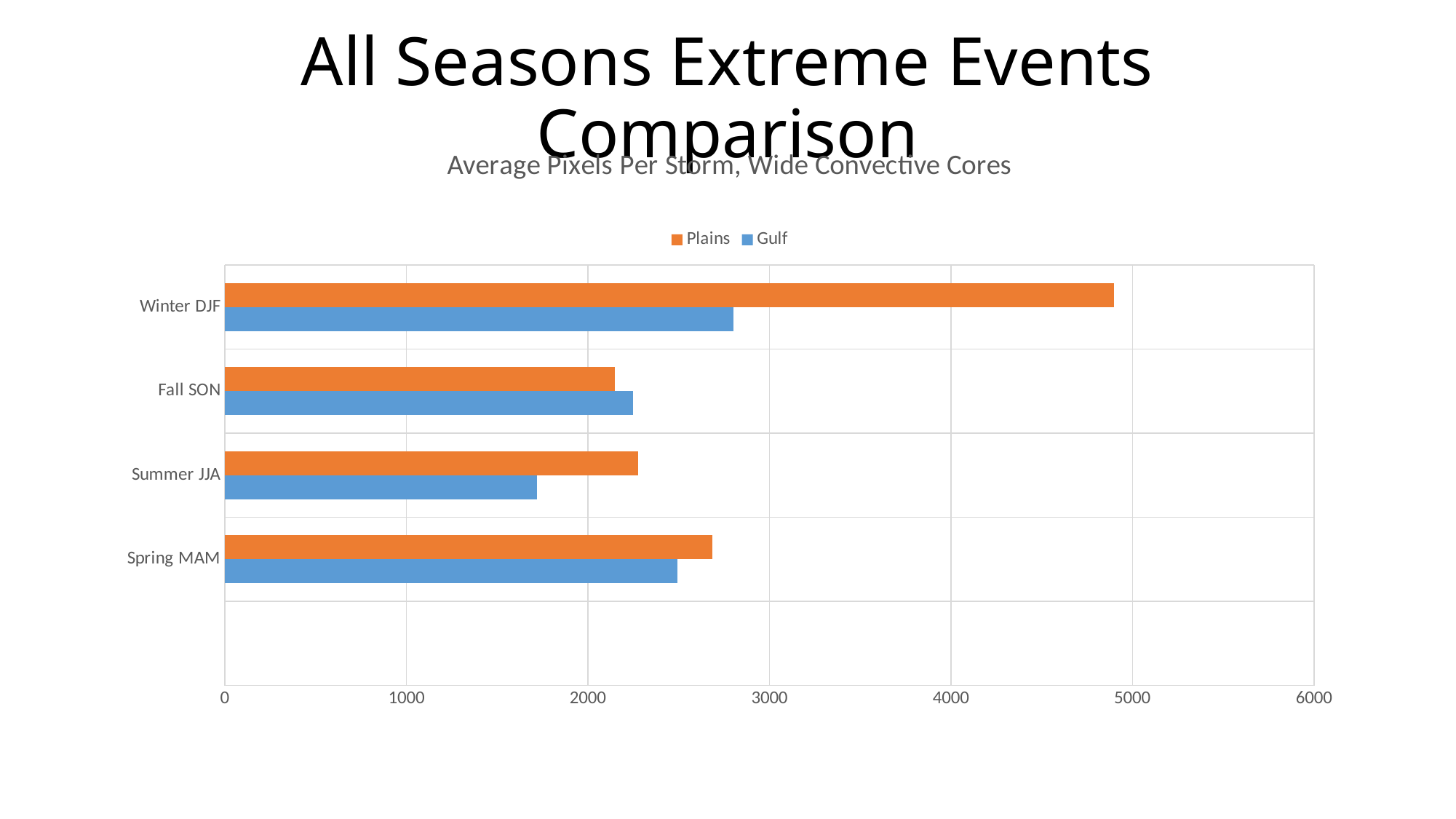
What is the subtitle of the chart? Average Pixels Per Storm, Wide Convective Cores How many seasons are shown on the chart? 4 What kind of chart is shown on the slide? bar chart Is the Plains value for Winter DJF greater or less than 4000? greater Which season has the lowest Gulf value? Summer JJA Which season has the highest Gulf value? Winter DJF Which season has the highest Plains value? Winter DJF How many series does the legend list? 2 For Winter DJF, which is larger, the Plains value or the Gulf value? Plains Which two series are listed in the legend? Plains and Gulf For Summer JJA, which is larger, the Plains value or the Gulf value? Plains Is the Gulf value for Summer JJA greater or less than 2000? less